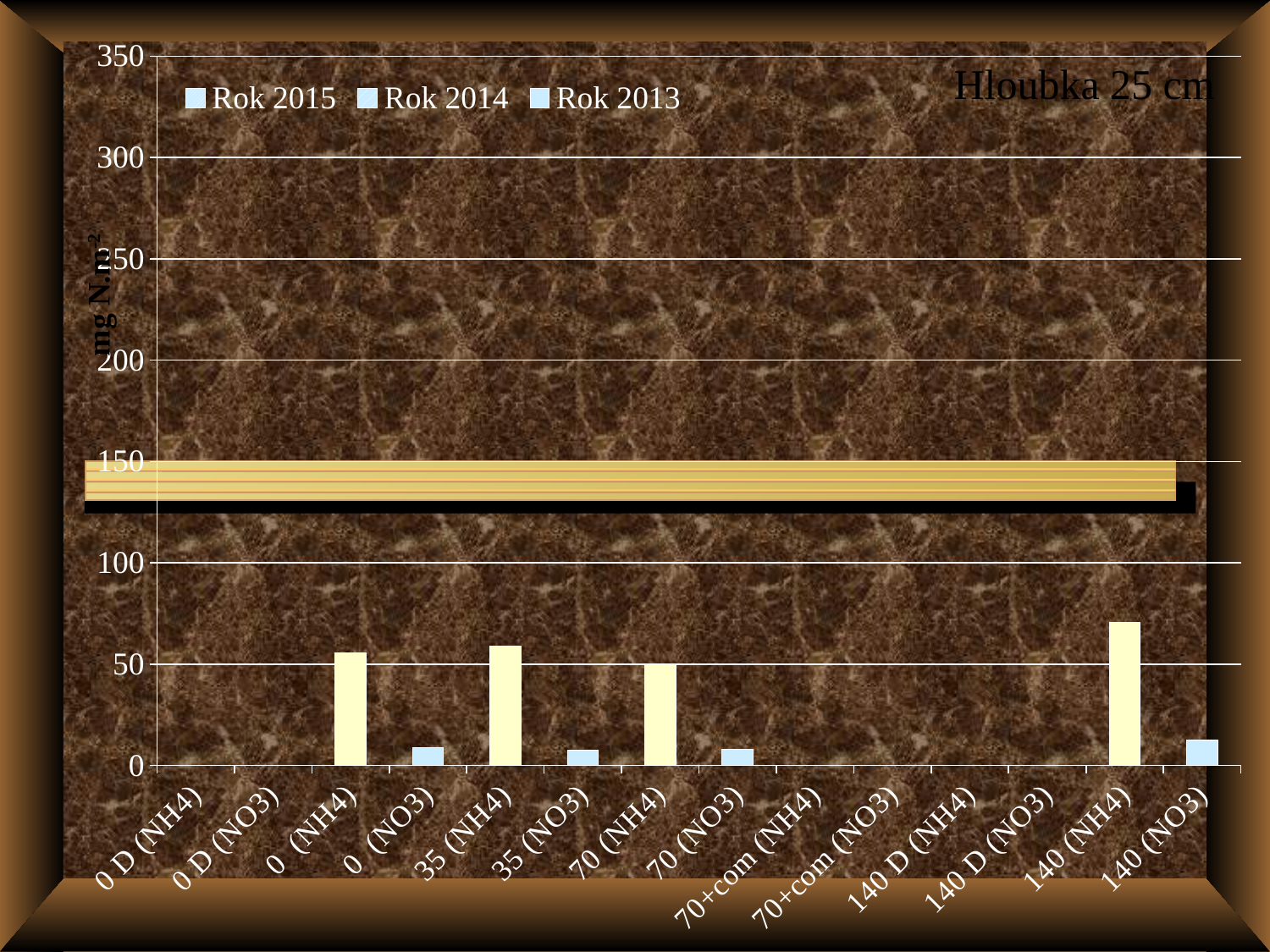
What are the three legend entries of the chart? Rok 2015, Rok 2014, Rok 2013 How many categories are shown on the x axis? 14 Is the value for 35 (NH4) greater or less than 100? less What kind of chart is shown on the slide? bar chart Which is larger, the value for 140 (NH4) or the value for 35 (NH4)? 140 (NH4) Is the value for 140 (NH4) greater or less than 50? greater What is the title of the chart? Hloubka 25 cm Is the value for 140 (NO3) greater or less than 50? less Which is larger, the value for 70 (NH4) or the value for 70 (NO3)? 70 (NH4) How many series does the legend list? 3 Which category has the highest bar? 140 (NH4)